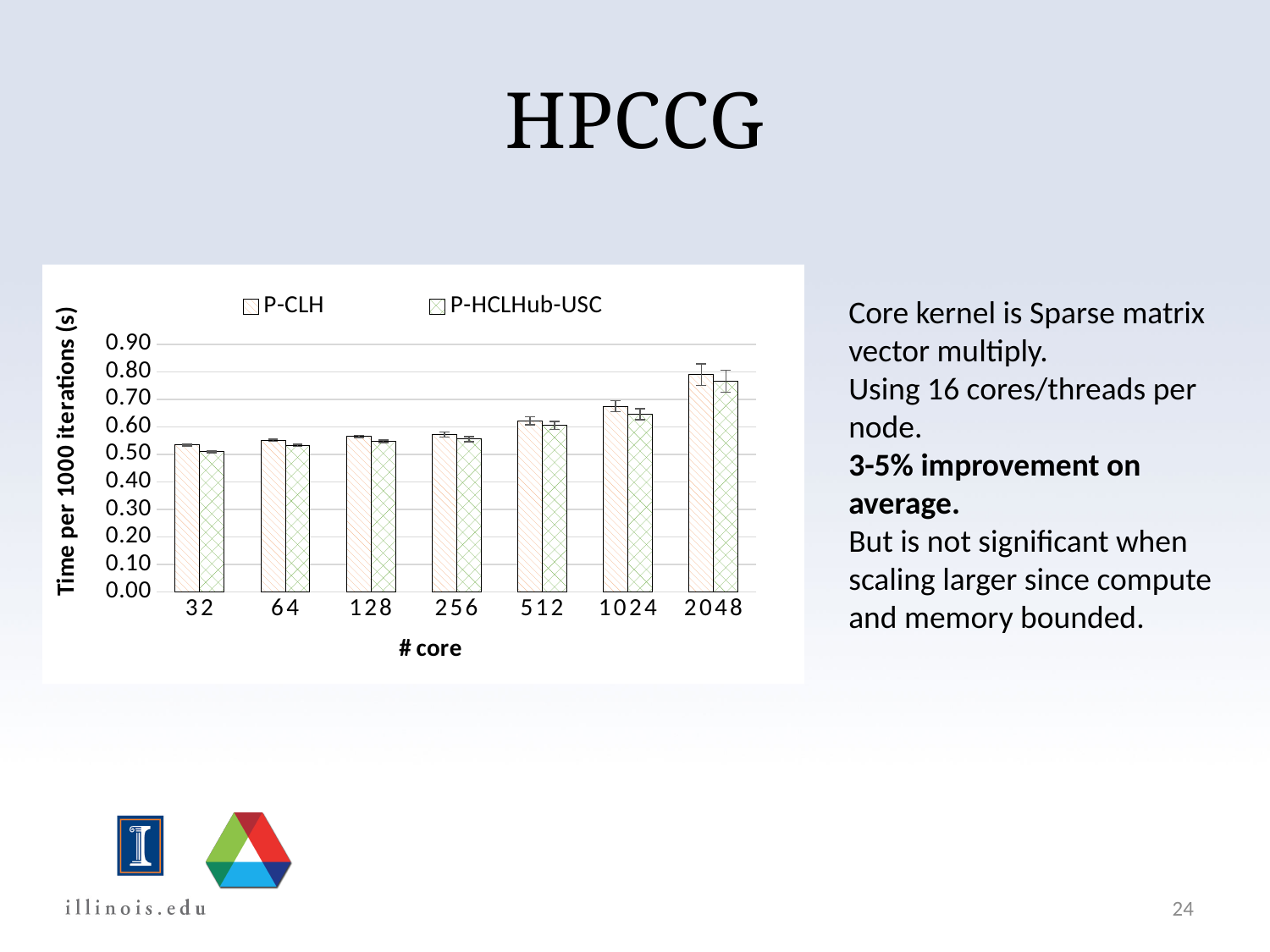
What is the title of the x axis? # core Which is larger for P-CLH: the value at 1024 cores or the value at 512 cores? 1024 cores How many core-count categories are shown on the x axis? 7 What kind of chart is shown on the slide? bar chart Is the P-CLH value at 2048 cores greater or less than 0.70? greater Is the P-HCLHub-USC value at 64 cores greater or less than 0.60? less Is the P-HCLHub-USC value at 1024 cores greater or less than 0.60? greater How many series does the chart legend list? 2 Does the time per 1000 iterations rise or fall as the number of cores increases? rises At which core count is the P-HCLHub-USC bar lowest? 32 At which core count is the P-CLH bar highest? 2048